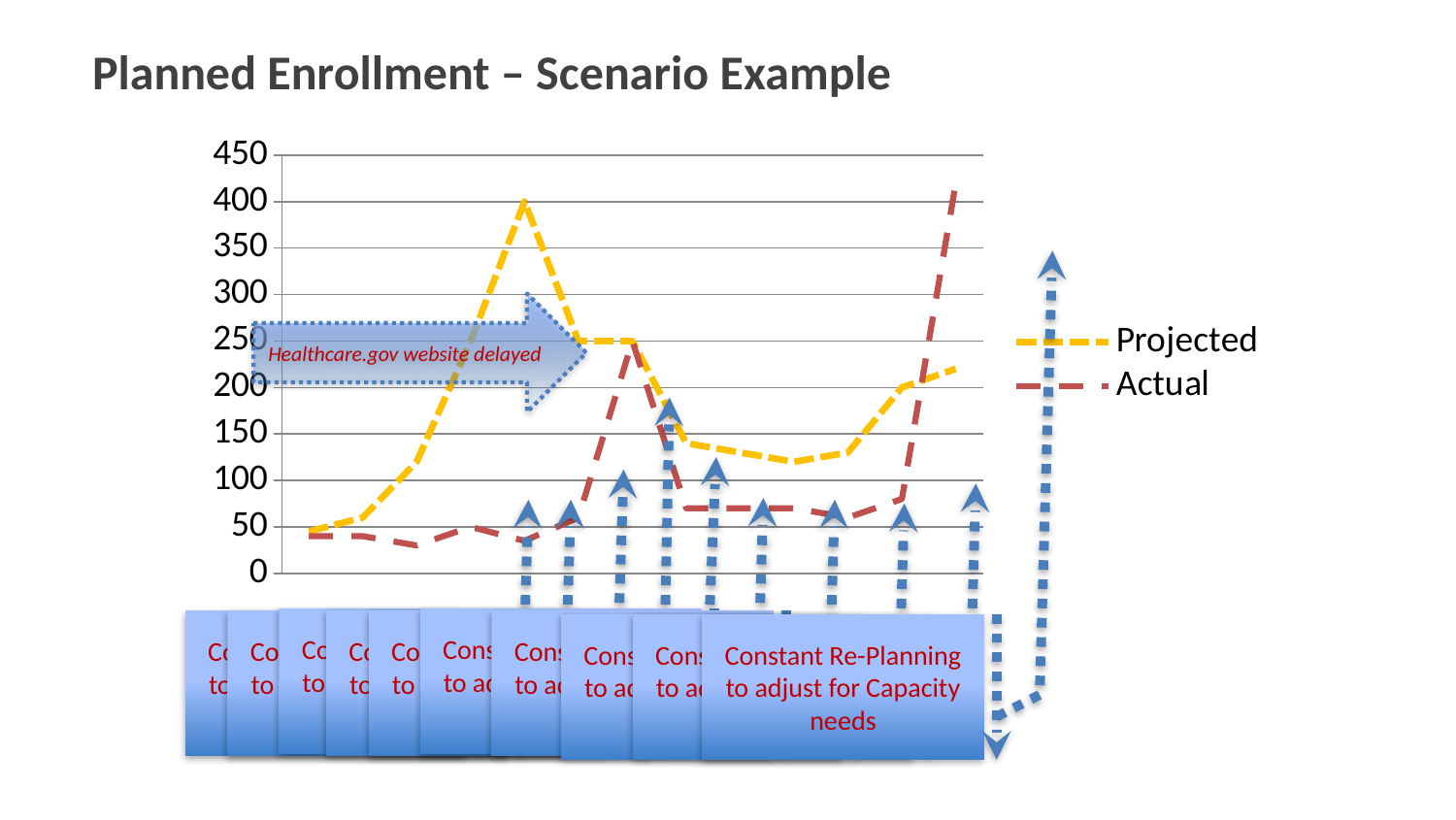
Is the value of the Actual series at the far right end of the chart greater or less than 300? greater What are the two series named in the chart legend? Projected and Actual Does the Actual series rise or fall at the right end of the chart? rise Is the first value of the Projected series greater or less than 100? less What is the title of the slide containing the chart? Planned Enrollment – Scenario Example Is the first value of the Actual series greater or less than 100? less Does the Projected series rise or fall between its starting point and its peak? rise What is the highest value shown on the chart's vertical axis? 450 What kind of chart is shown on the slide? Line chart How many series does the chart legend list? 2